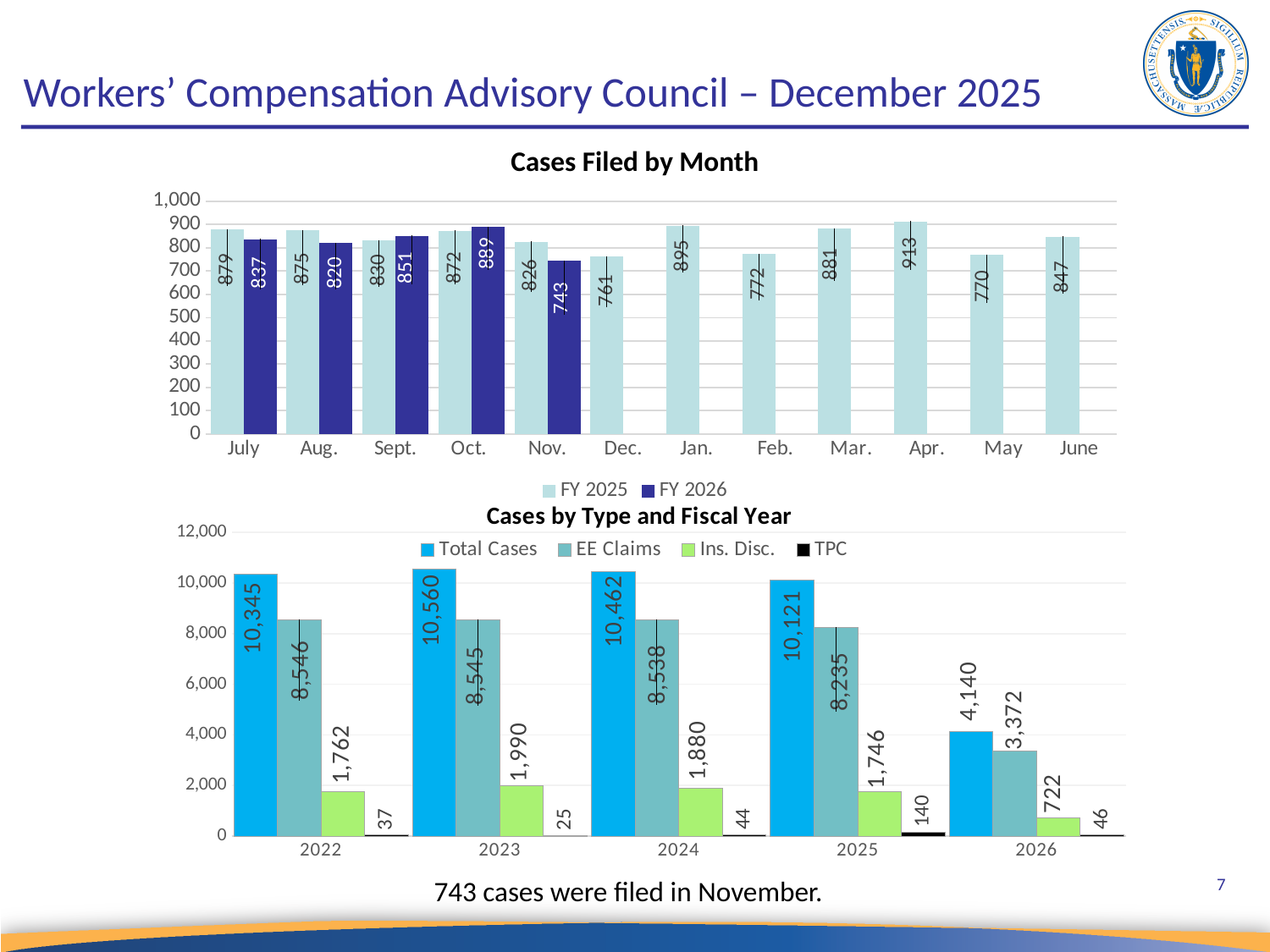
In the 'Cases by Type and Fiscal Year' chart, what is the TPC value for 2025? 140 In the 'Cases Filed by Month' chart, how many months are shown on the x axis? 12 In the 'Cases Filed by Month' chart, which month has the lowest FY 2025 value? Dec. In the 'Cases Filed by Month' chart, which month has the highest FY 2025 value? Apr. In the 'Cases Filed by Month' chart, how many cases were filed in November for FY 2026? 743 In the 'Cases by Type and Fiscal Year' chart, what is the difference between EE Claims in 2024 and 2025? 303 In the 'Cases by Type and Fiscal Year' chart, what is the Total Cases value for 2023? 10,560 In the 'Cases Filed by Month' chart, what is the difference between the FY 2025 and FY 2026 values for October? 17 In the 'Cases Filed by Month' chart, which is larger for September: FY 2025 or FY 2026? FY 2026 What kind of chart is 'Cases by Type and Fiscal Year'? Bar chart In the 'Cases by Type and Fiscal Year' chart, which year has the highest Ins. Disc. value? 2023 In the 'Cases Filed by Month' chart, how many series does the legend list? 2